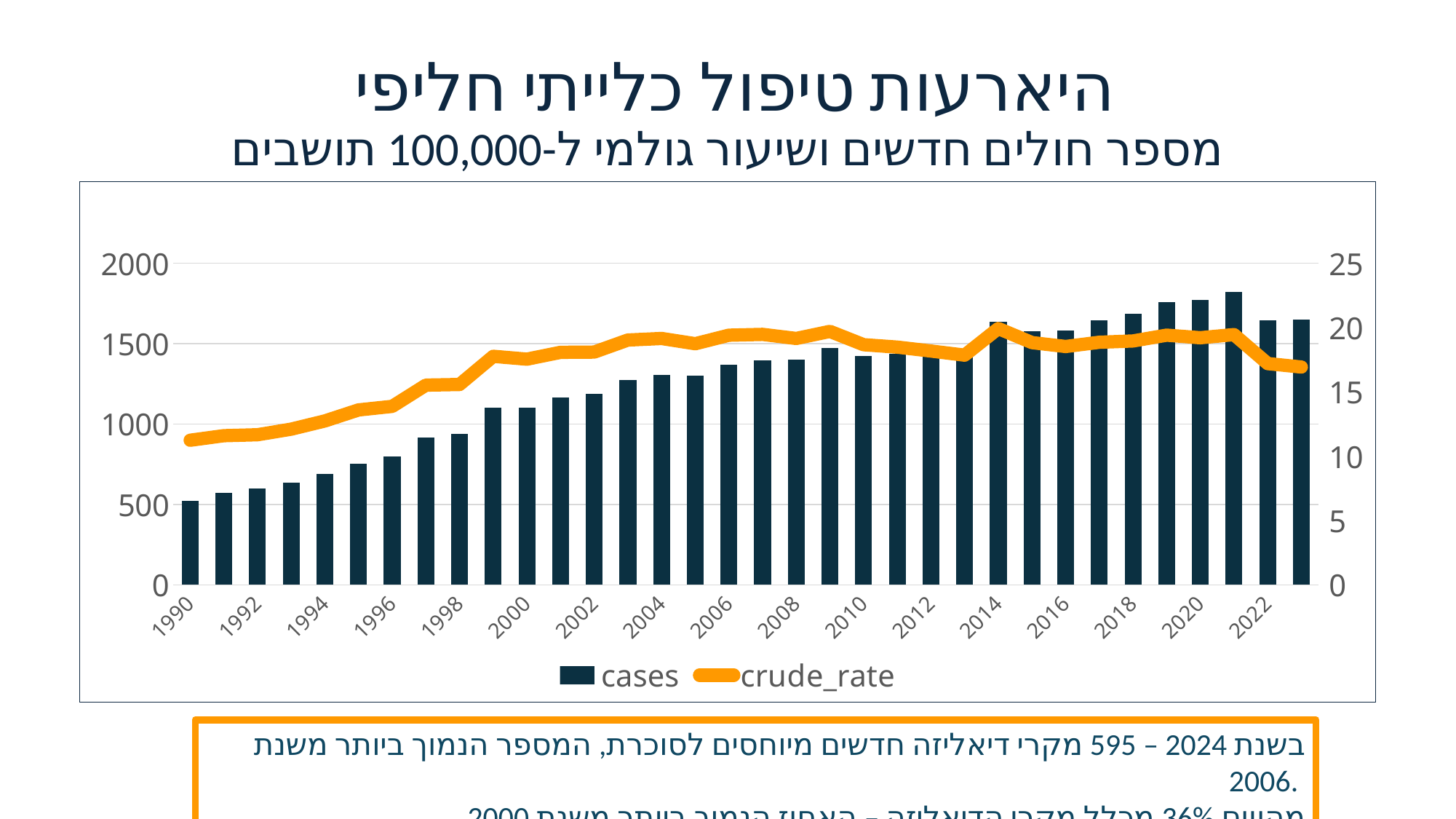
Do the cases bars generally rise or fall from 1990 to 2021? rise Which year has a higher crude_rate, 1990 or 2008? 2008 What are the two series named in the legend? cases and crude_rate Is the crude_rate value for 1990 greater or less than 15? less Which year has the highest number of cases (tallest bar)? 2021 Which year has more cases, 2021 or 2022? 2021 Is the value of cases for 2021 greater or less than 1500? greater What kind of chart is shown on the slide? A bar chart combined with a line How many series does the legend list? 2 Which year has the lowest number of cases (shortest bar)? 1990 Is the value of cases for 1990 greater or less than 1000? less